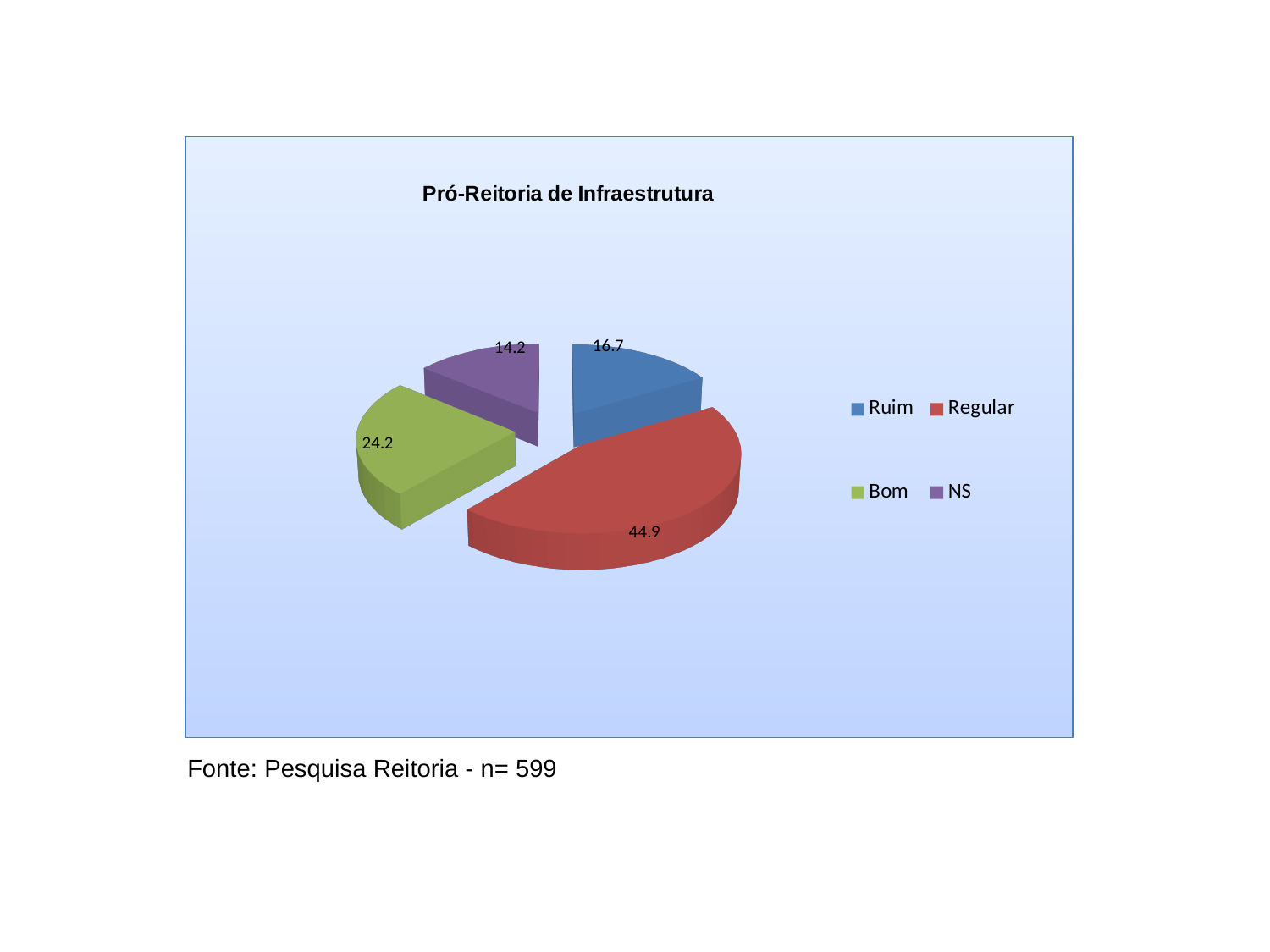
Which category has the smallest slice? NS Which is larger, the value for Bom or the value for Ruim? Bom Which category has the largest slice? Regular What is the difference between the values for Regular and Bom? 20.7 What is the value for Ruim? 16.7 What kind of chart is shown on the slide? Pie chart What is the value for Bom? 24.2 What is the title of the chart? Pró-Reitoria de Infraestrutura What is the value for NS? 14.2 What is the difference between the values for Ruim and NS? 2.5 How many slices does the pie chart have? 4 What is the value for Regular? 44.9